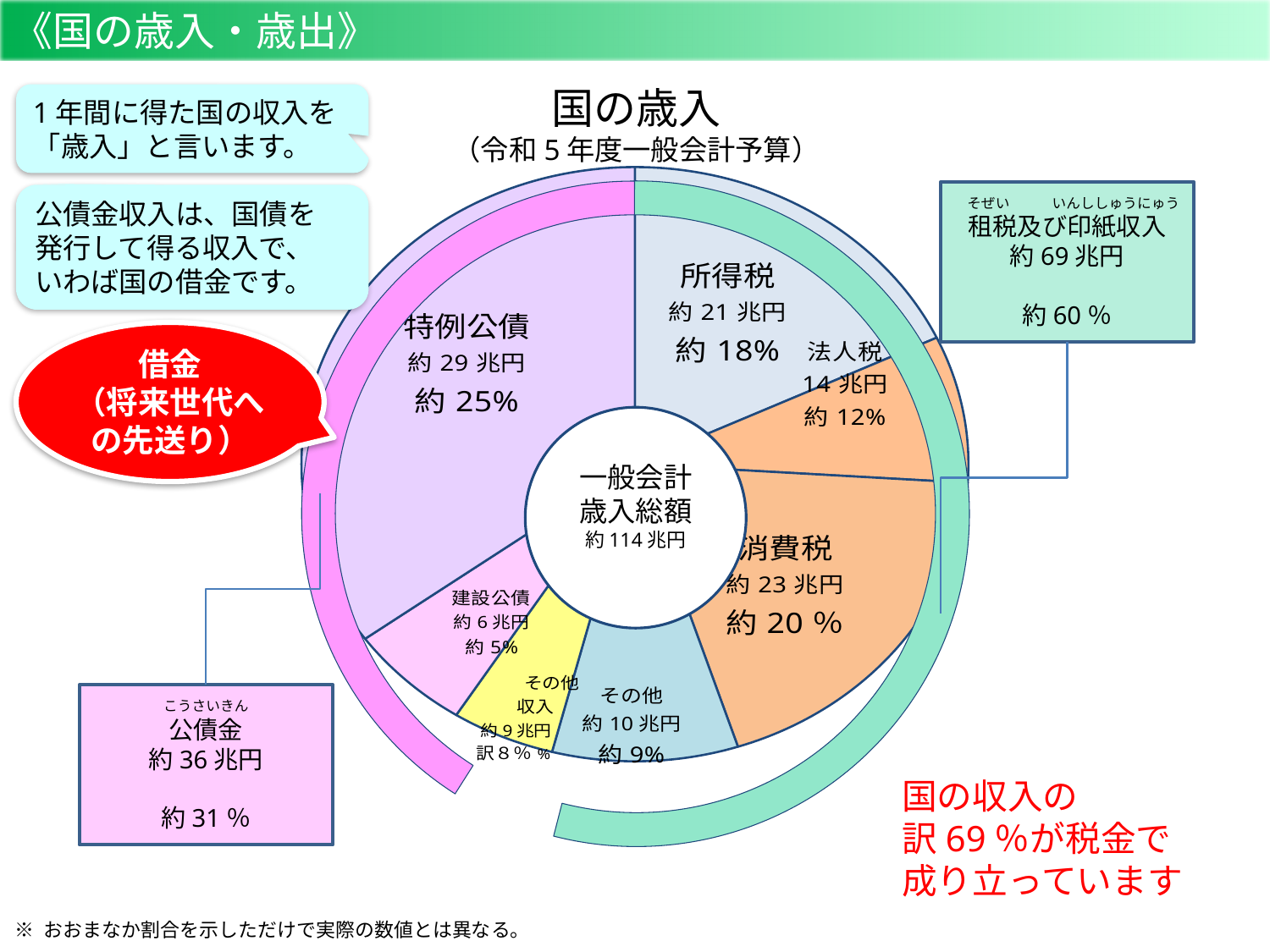
所得税の金額はいくらですか。 約 21 兆円 円グラフはいくつの項目に分かれていますか。 7 消費税と所得税では、どちらの割合が大きいですか。 消費税 このスライドのグラフはどの種類のグラフですか。 円グラフ 円グラフの中心に示されている一般会計歳入総額はいくらですか。 約 114 兆円 グラフのタイトルは何ですか。 国の歳入（令和5年度一般会計予算） 法人税の割合は何％ですか。 約 12% 円グラフの中で最も割合が小さい項目はどれですか。 建設公債 外側の緑色の帯で示されている租税及び印紙収入の割合は何％ですか。 約 60 % 特例公債の金額はいくらですか。 約 29 兆円 消費税の割合は何％ですか。 約 20 % 円グラフの中で最も割合が大きい項目はどれですか。 特例公債